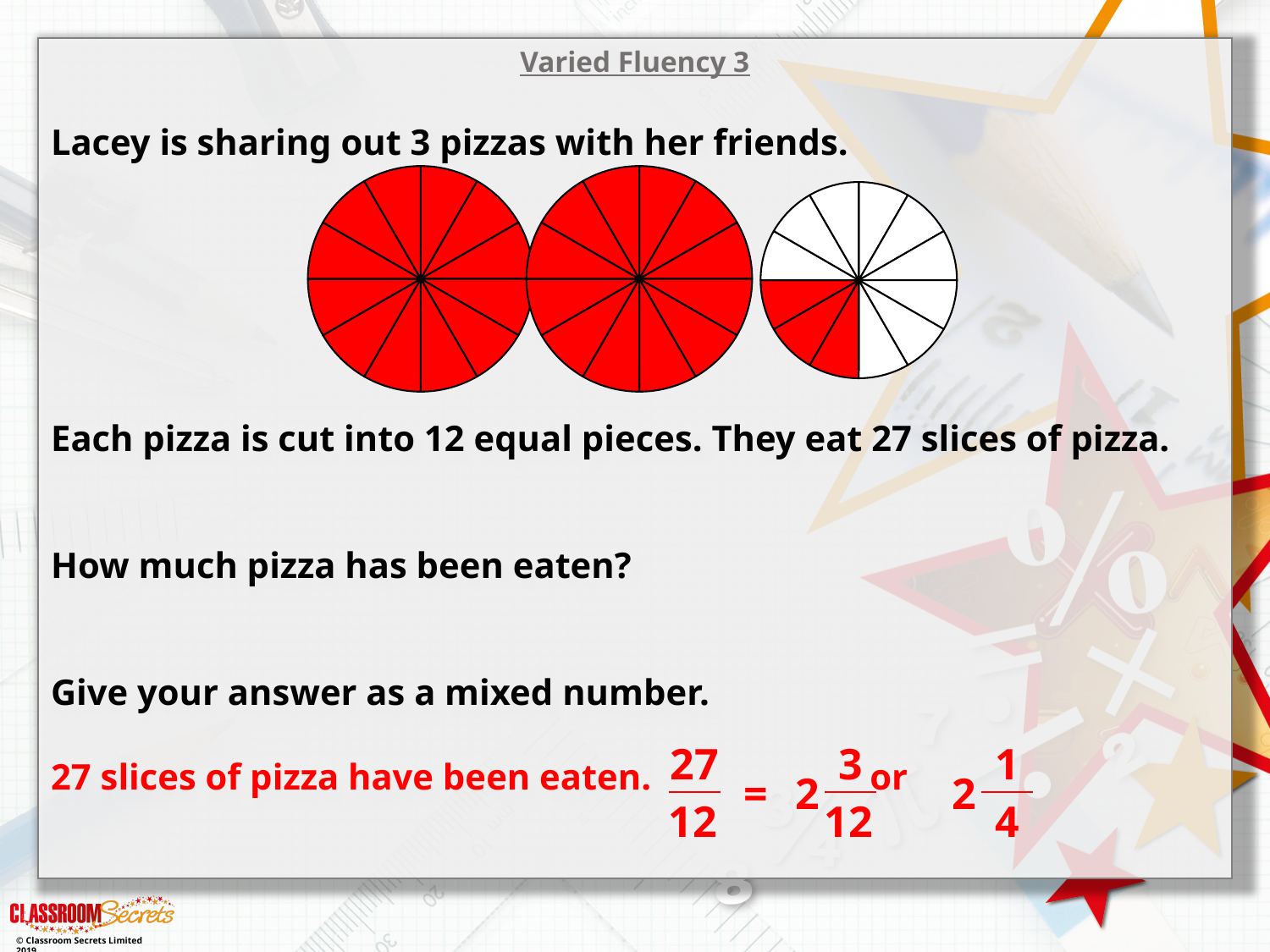
Which pizza diagram has the fewest red slices: the first, second or third? Third In the third (rightmost) pizza diagram, how many slices are left white? 9 How many of the pizza diagrams are completely shaded red? 2 Into how many equal pieces is each pizza diagram divided? 12 What fraction of the third (rightmost) pizza diagram is shaded red? 3/12 What simplified mixed number does the slide give for the amount of pizza eaten? 2 1/4 What colour is used to shade the eaten slices in the pizza diagrams? Red What fraction is written on the slide to represent the pizza eaten before it is converted to a mixed number? 27/12 According to the slide, how many slices of pizza have been eaten in total? 27